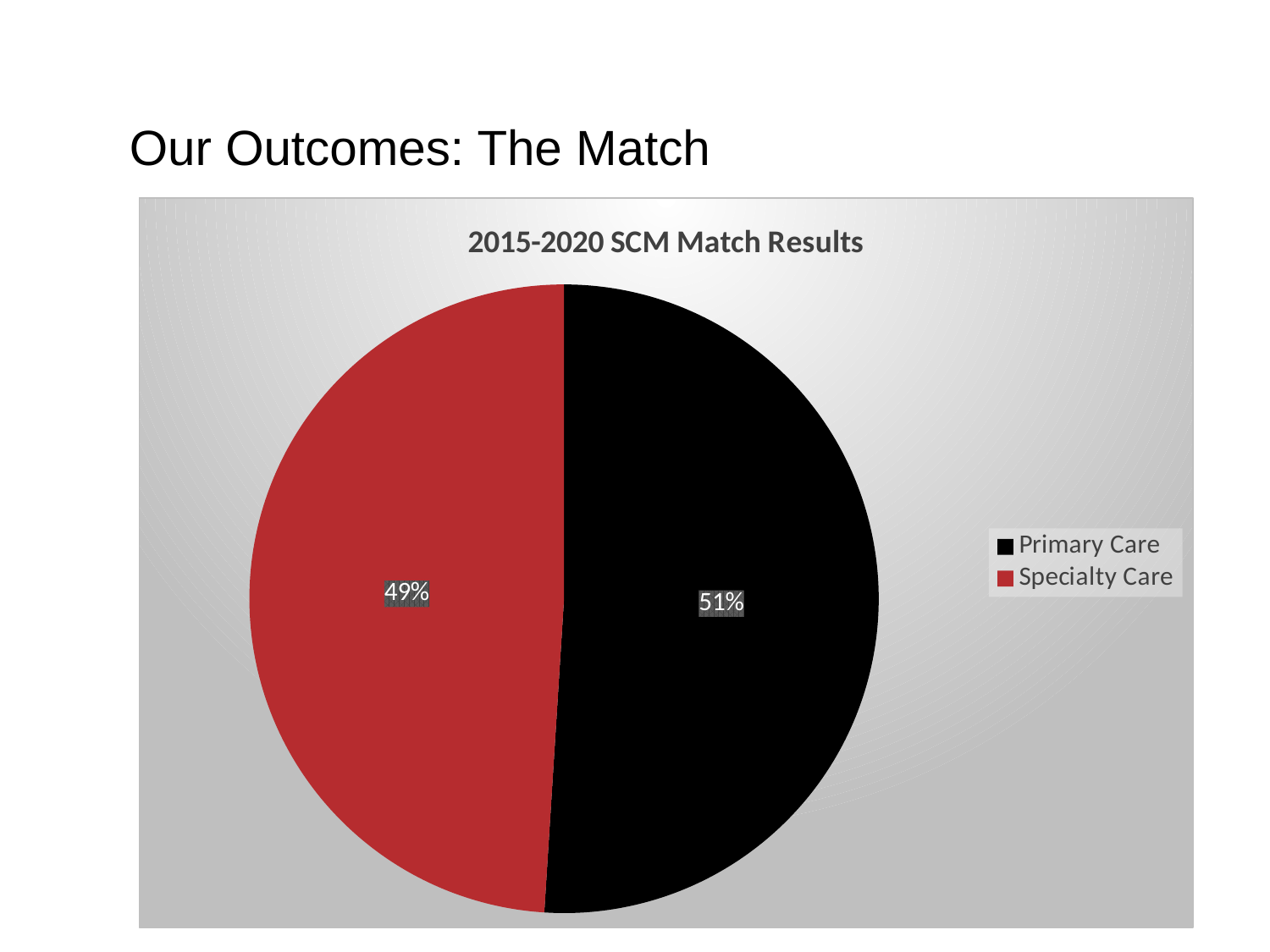
Which slice is larger, Primary Care or Specialty Care? Primary Care What colour is the Specialty Care slice? red What kind of chart is shown on the slide? pie chart What share of the pie is Specialty Care? 49% What is the title of the chart? 2015-2020 SCM Match Results How many entries does the legend list? 2 How many slices does the pie chart have? 2 Which category has the smallest share of the pie? Specialty Care What is the difference in percentage points between the Primary Care and Specialty Care shares? 2% What share of the pie is Primary Care? 51%